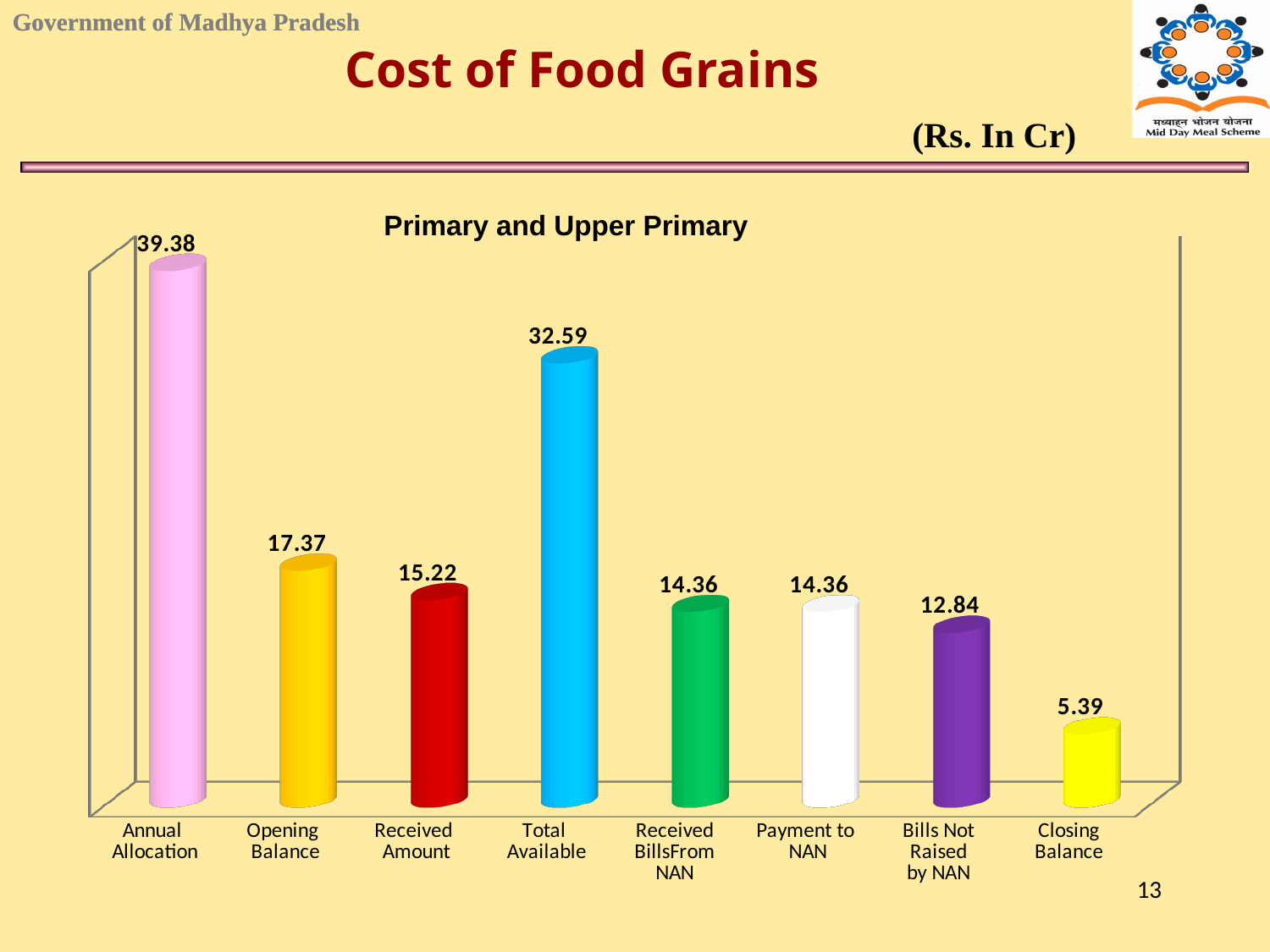
Which category has the highest value? Annual Allocation What is the value for Closing Balance? 5.39 How many categories are shown in the chart? 8 What is the difference between Annual Allocation and Total Available? 6.79 What kind of chart is shown on the slide? Bar chart Which category has the lowest value? Closing Balance What is the title of the chart? Primary and Upper Primary What is the value for Annual Allocation? 39.38 What is the value for Bills Not Raised by NAN? 12.84 What is the difference between Opening Balance and Received Amount? 2.15 What is the value for Total Available? 32.59 Which is larger, Opening Balance or Bills Not Raised by NAN? Opening Balance